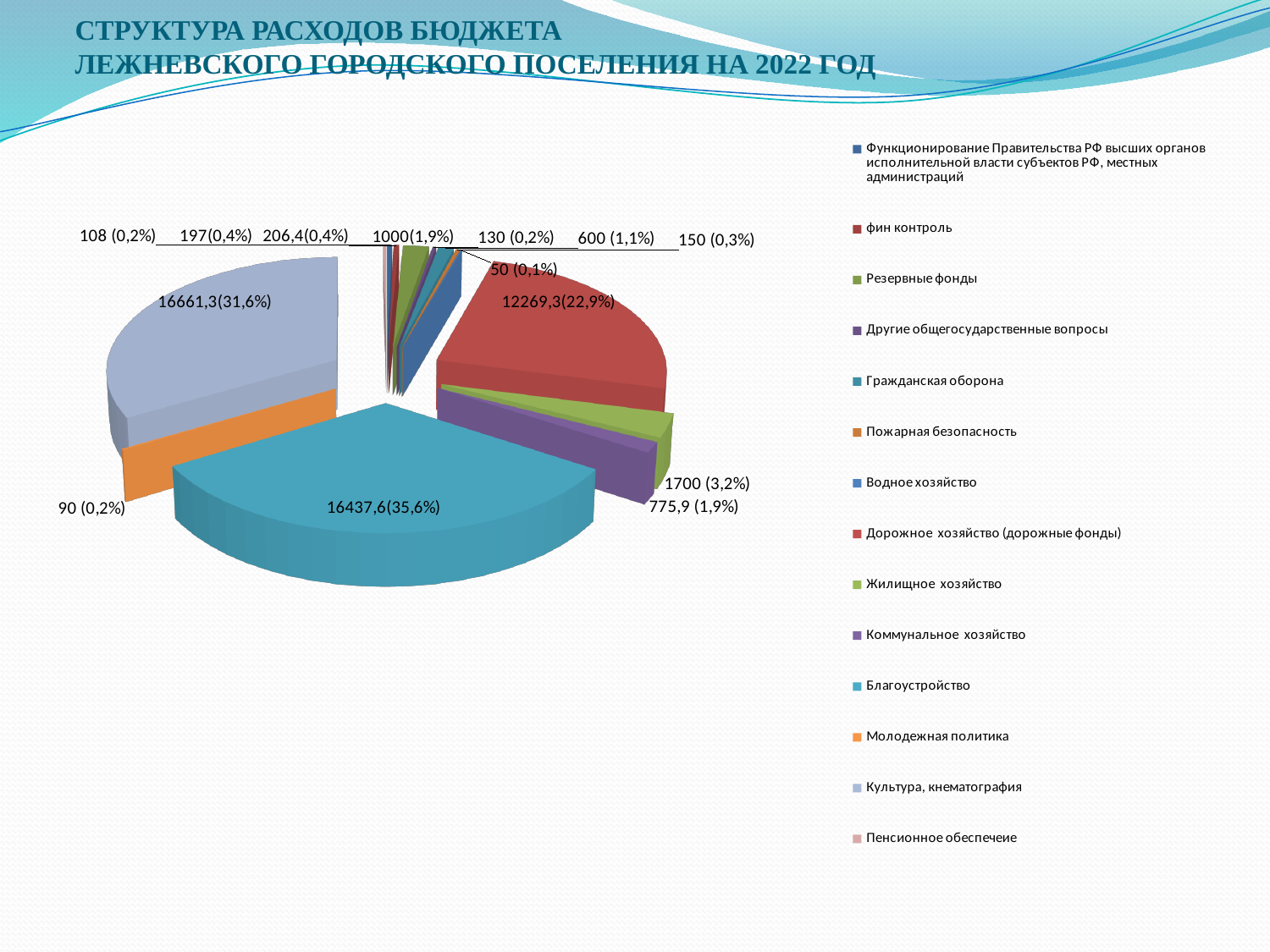
Which has the larger value, Жилищное хозяйство or Коммунальное хозяйство? Жилищное хозяйство How many entries does the legend of the pie chart list? 14 What value is labelled for Коммунальное хозяйство? 775,9 What share of the pie does Культура, кнематография have? 31,6% What kind of chart is shown on the slide? pie chart What share of the pie does Благоустройство have? 35,6% What value is labelled for Благоустройство? 16437,6 What value is labelled for Молодежная политика? 90 What value is labelled for Жилищное хозяйство? 1700 What share of the pie does Дорожное хозяйство (дорожные фонды) have? 22,9% What value is labelled for Дорожное хозяйство (дорожные фонды)? 12269,3 What is the difference between the values for Жилищное хозяйство and Коммунальное хозяйство? 924,1